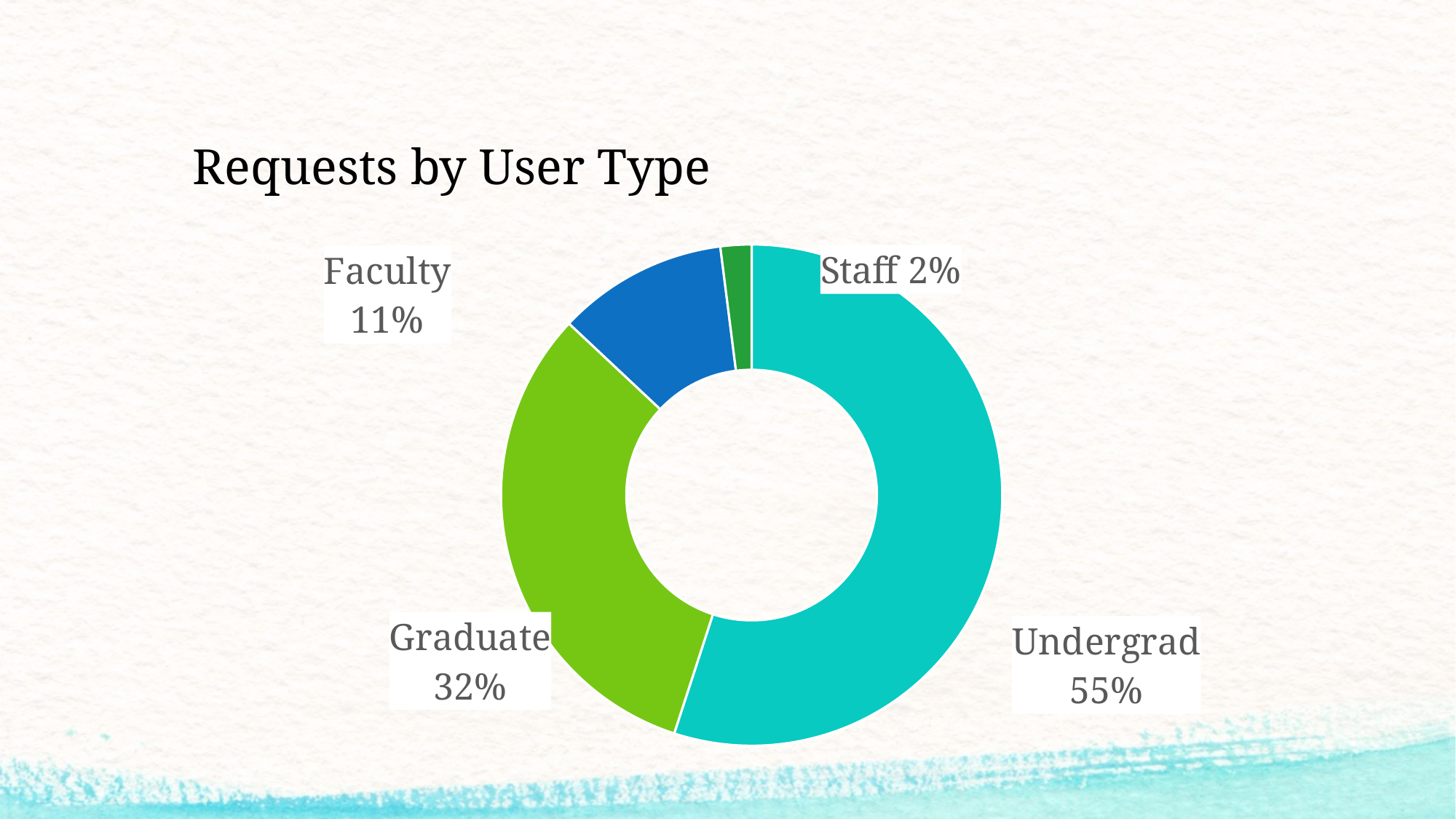
What share of requests comes from Graduate users? 32% What kind of chart is shown on the slide? Pie chart (doughnut) What share of requests comes from Faculty? 11% What share of requests comes from Staff? 2% What is the title of the chart? Requests by User Type What is the difference in percentage points between the Faculty and Staff shares? 9 Which user type accounts for the smallest share of requests? Staff What is the difference in percentage points between the Undergrad and Graduate shares? 23 Which has a larger share of requests, Graduate or Faculty? Graduate How many user types are shown in the chart? 4 What share of requests comes from Undergrad users? 55% Which user type accounts for the largest share of requests? Undergrad